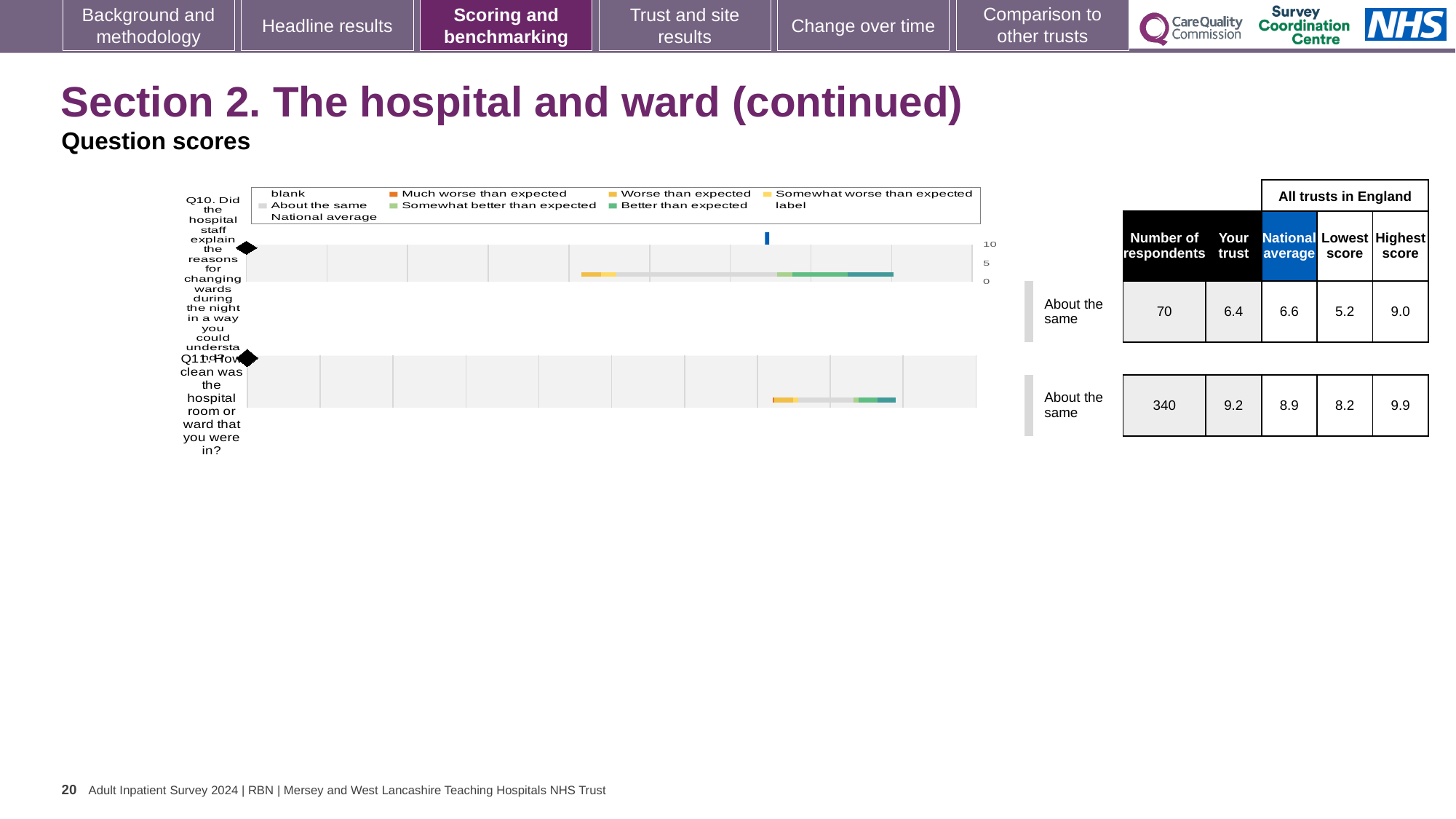
What kind of chart is used to show the question scores for Q10 and Q11? Bar chart Which question has the higher 'Your trust' score, Q10 or Q11? Q11 For Q11, which is higher: the trust's score or the national average? Your trust (9.2) What is the national average score for Q10? 6.6 What benchmark category is shown next to the Q10 chart? About the same What is the 'Your trust' score for Q10 (explaining reasons for changing wards during the night)? 6.4 What is the lowest score among all trusts in England for Q10? 5.2 What is the 'Your trust' score for Q11 (how clean was the hospital room or ward)? 9.2 What is the difference between the highest and lowest trust scores in England for Q10? 3.8 How many respondents answered Q11? 340 How many questions are plotted on the slide? 2 What is the difference between the highest and lowest trust scores in England for Q11? 1.7